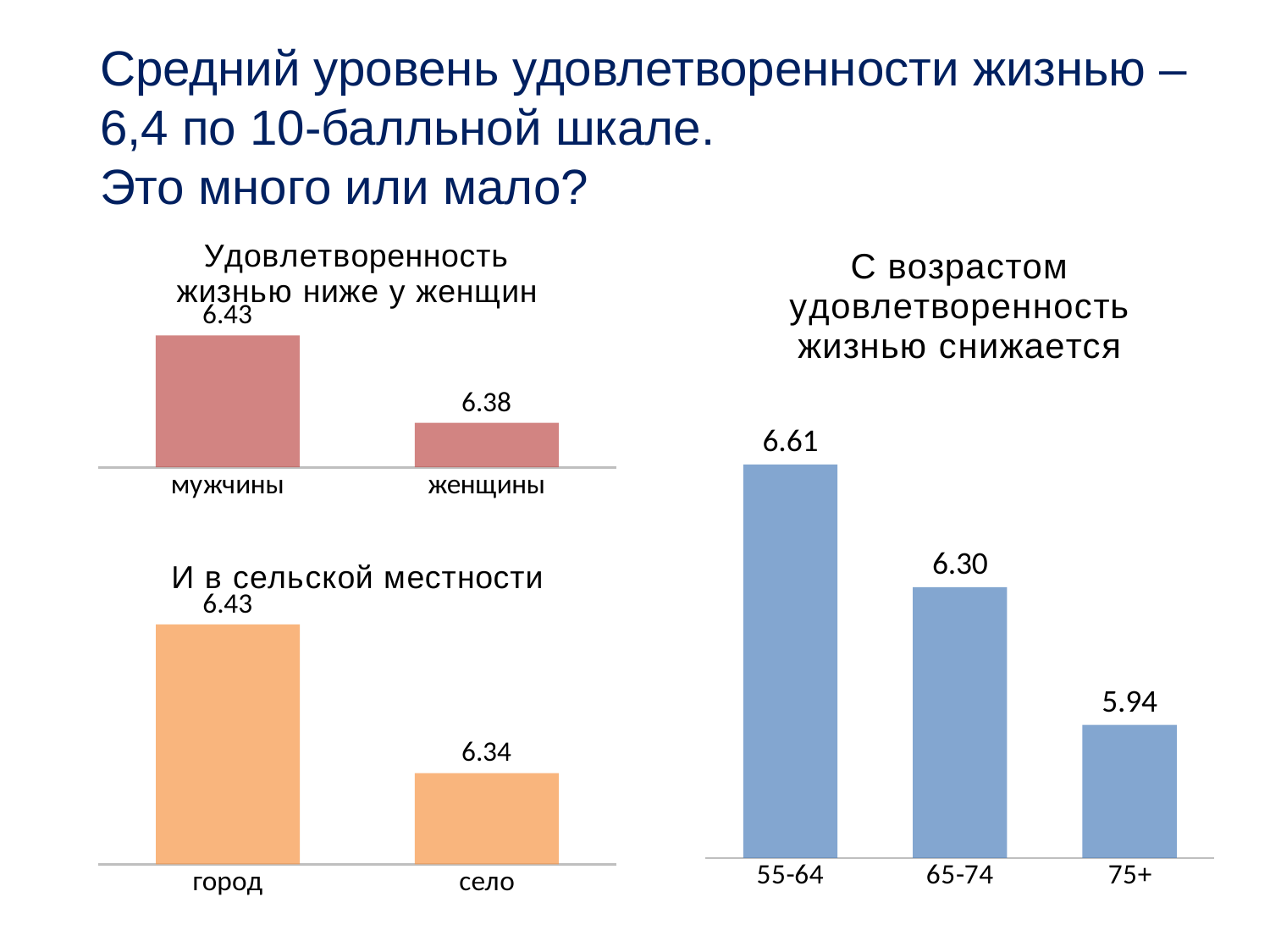
In the right-hand chart, which age group has the lowest value? 75+ In the top-left chart (Удовлетворенность жизнью ниже у женщин), what is the value for женщины? 6.38 In the right-hand chart, what is the difference between the values for 55-64 and 65-74? 0.31 In the bottom-left chart (И в сельской местности), what is the value for село? 6.34 In the top-left chart (Удовлетворенность жизнью ниже у женщин), what is the value for мужчины? 6.43 In the bottom-left chart (И в сельской местности), which category has the higher value, город or село? город In the right-hand chart, do the values rise or fall from the 55-64 group to the 75+ group? fall How many age groups are shown in the right-hand chart? 3 In the right-hand chart (С возрастом удовлетворенность жизнью снижается), what is the value for the 55-64 age group? 6.61 In the bottom-left chart, what is the difference between the values for город and село? 0.09 In the right-hand chart (С возрастом удовлетворенность жизнью снижается), what is the value for the 75+ age group? 5.94 In the top-left chart, what is the difference between the values for мужчины and женщины? 0.05